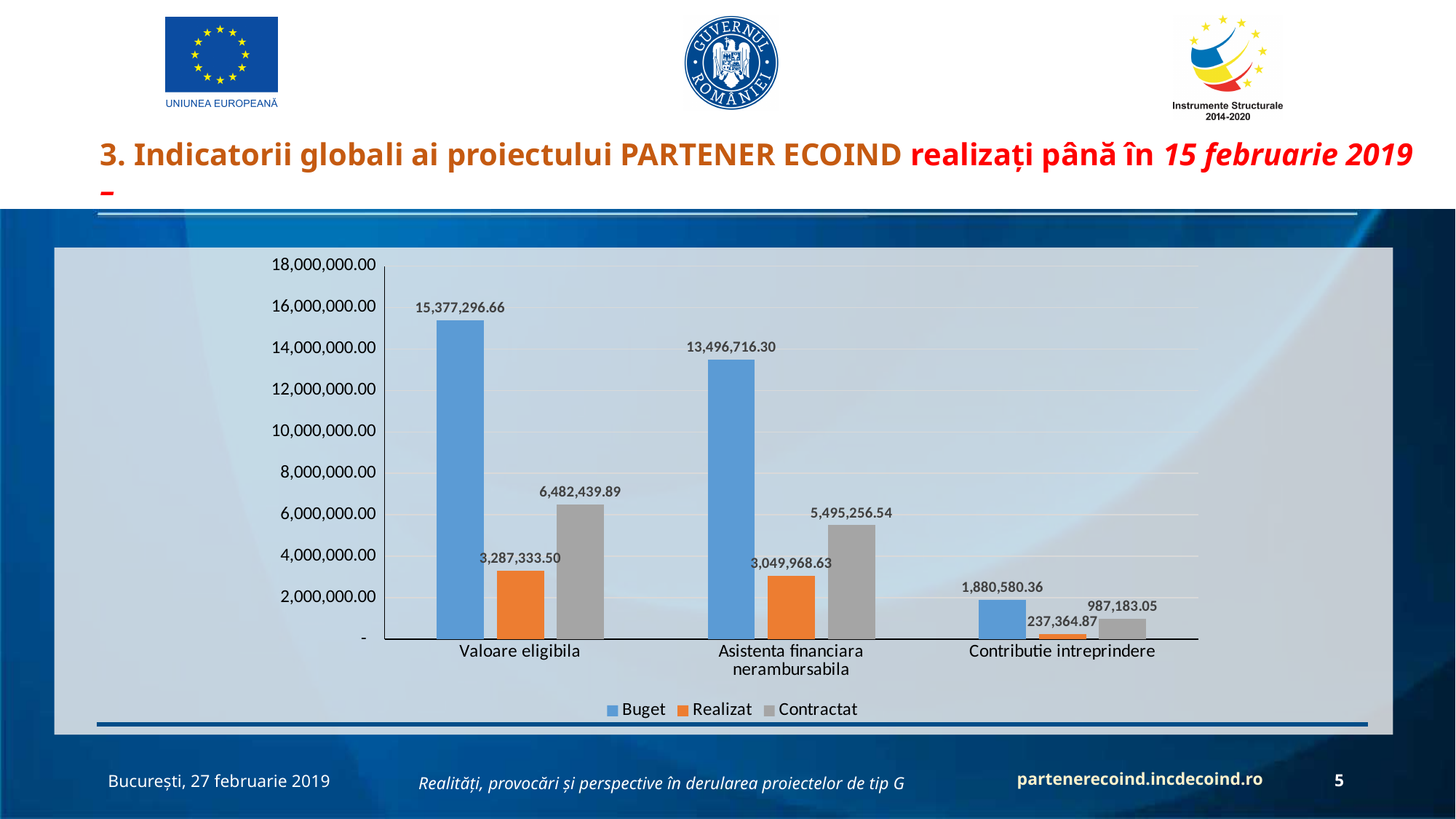
Which series is shown in orange in the legend? Realizat What is the Realizat value for Asistenta financiara nerambursabila? 3,049,968.63 What is the Buget value for Valoare eligibila? 15,377,296.66 Which category has the lowest Realizat value? Contributie intreprindere What kind of chart is shown on the slide? bar chart Which is larger for Valoare eligibila: the Contractat value or the Realizat value? Contractat How many series does the legend list? 3 What is the difference between the Buget values for Valoare eligibila and Asistenta financiara nerambursabila? 1,880,580.36 Is the Contractat value for Asistenta financiara nerambursabila greater or less than 6,000,000.00? less What is the Contractat value for Contributie intreprindere? 987,183.05 How many categories are shown on the x axis? 3 Which category has the highest Buget value? Valoare eligibila